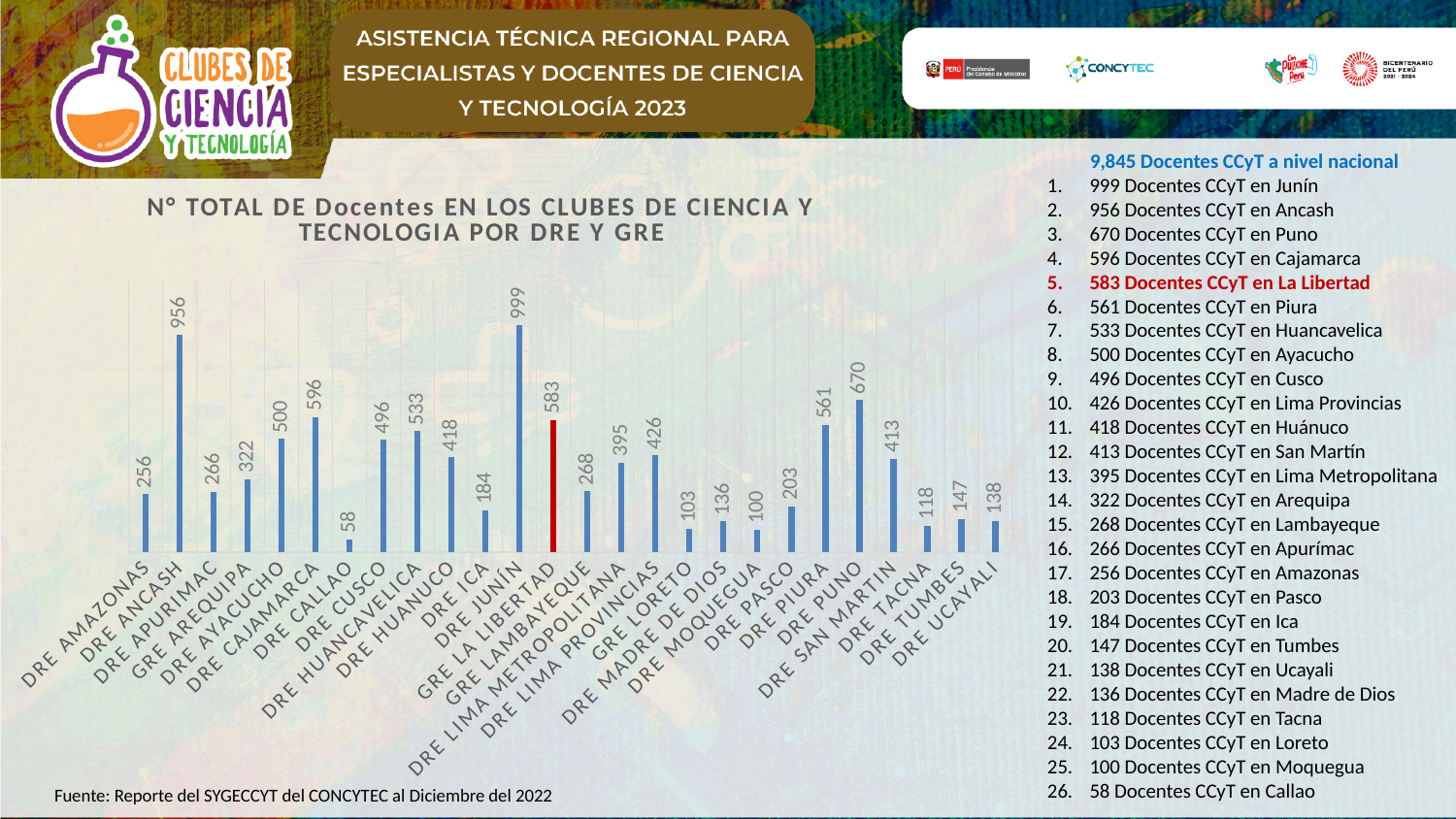
Which category has the lowest value? DRE CALLAO Which category has the highest value? DRE JUNIN Which is larger, the value for DRE PIURA or the value for DRE HUANCAVELICA? DRE PIURA What is the value for DRE JUNIN? 999 Which bar is highlighted in red in the chart? GRE LA LIBERTAD What is the difference between the values for DRE ANCASH and DRE PUNO? 286 What is the value for DRE CALLAO? 58 What type of chart is shown on the slide? Bar chart What is the difference between the values for DRE CAJAMARCA and DRE AYACUCHO? 96 How many categories are shown on the x axis of the chart? 26 What is the value for DRE MOQUEGUA? 100 What is the value for GRE LA LIBERTAD? 583